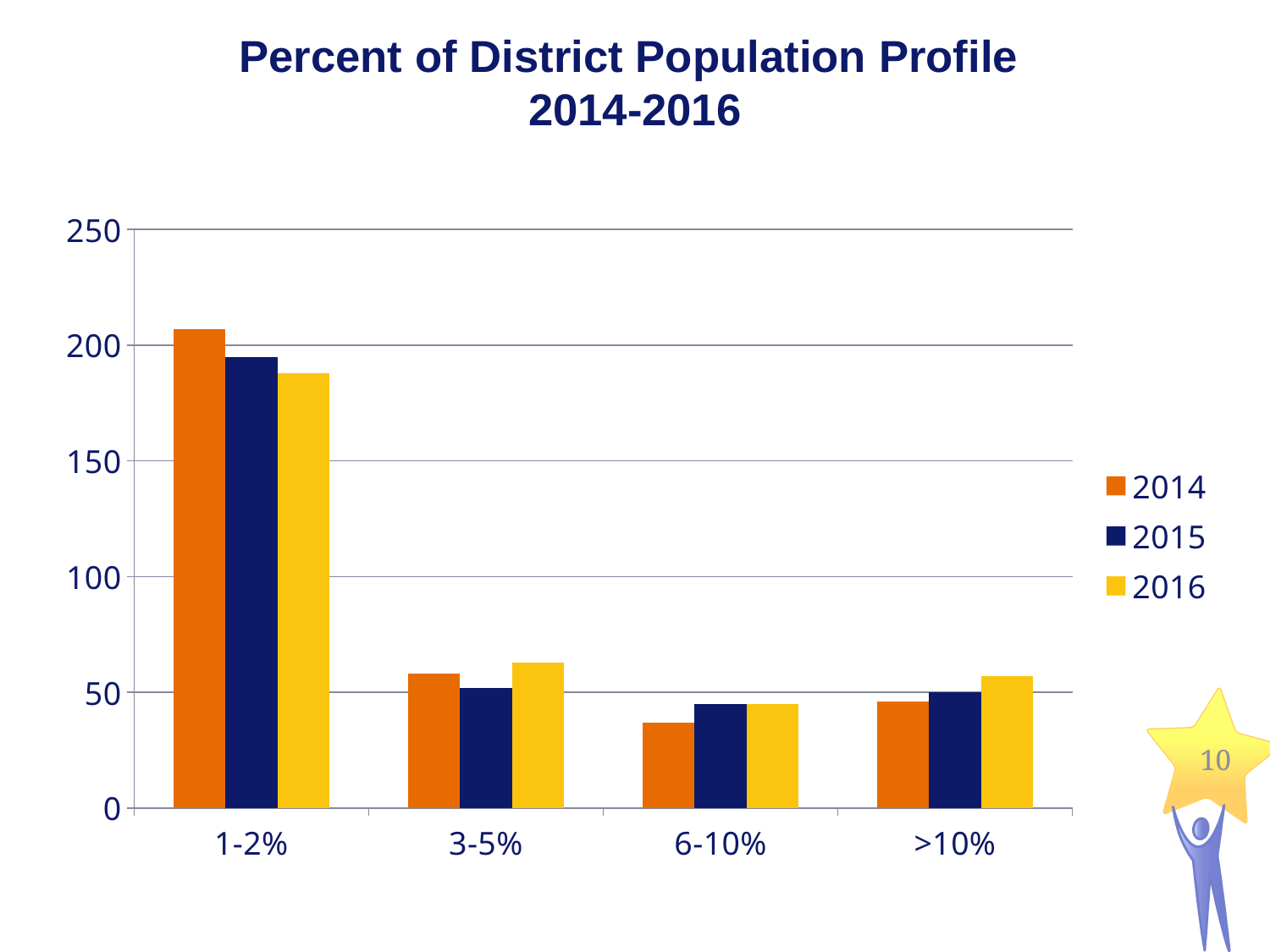
In the 1-2% category, which is larger: the value for 2014 or the value for 2016? 2014 Which category has the lowest value for 2014? 6-10% Is the value for 2016 in the 1-2% category greater or less than 200? less How many series does the legend list? 3 What kind of chart is shown on the slide? bar chart What is the title of the chart? Percent of District Population Profile 2014-2016 Is the value for 2014 in the 1-2% category greater or less than 200? greater Which category has the highest value for 2014? 1-2% Which category has the lowest value for 2016? 6-10% Is the value for 2014 in the 6-10% category greater or less than 50? less How many categories are shown on the x axis? 4 In the >10% category, which is larger: the value for 2014 or the value for 2016? 2016